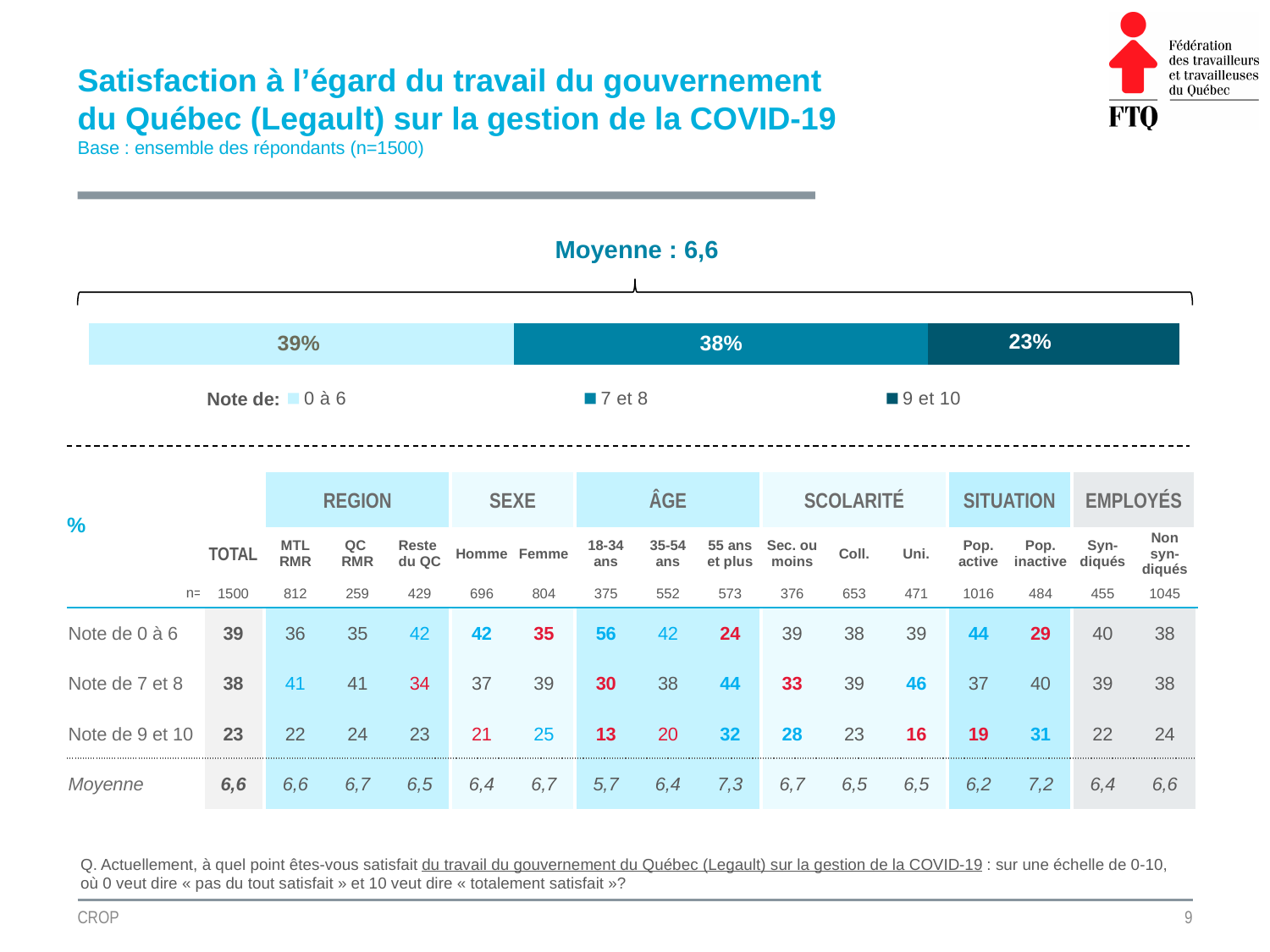
What type of chart is used to show the distribution of satisfaction scores? Stacked bar chart Which segment is larger in the stacked bar chart: 7 et 8 or 9 et 10? 7 et 8 What is the difference in percentage points between the 0 à 6 segment and the 9 et 10 segment? 16 Which score category has the smallest share in the stacked bar chart? 9 et 10 What is the average (Moyenne) score shown above the stacked bar chart? 6,6 What percentage of respondents gave a score of 9 et 10 in the stacked bar chart? 23% Which score category has the largest share in the stacked bar chart? 0 à 6 What is the difference in percentage points between the 7 et 8 segment and the 9 et 10 segment? 15 How many segments make up the stacked bar in the chart? 3 What percentage of respondents gave a score of 0 à 6 in the stacked bar chart? 39% How many series does the legend of the stacked bar chart list? 3 What percentage of respondents gave a score of 7 et 8 in the stacked bar chart? 38%